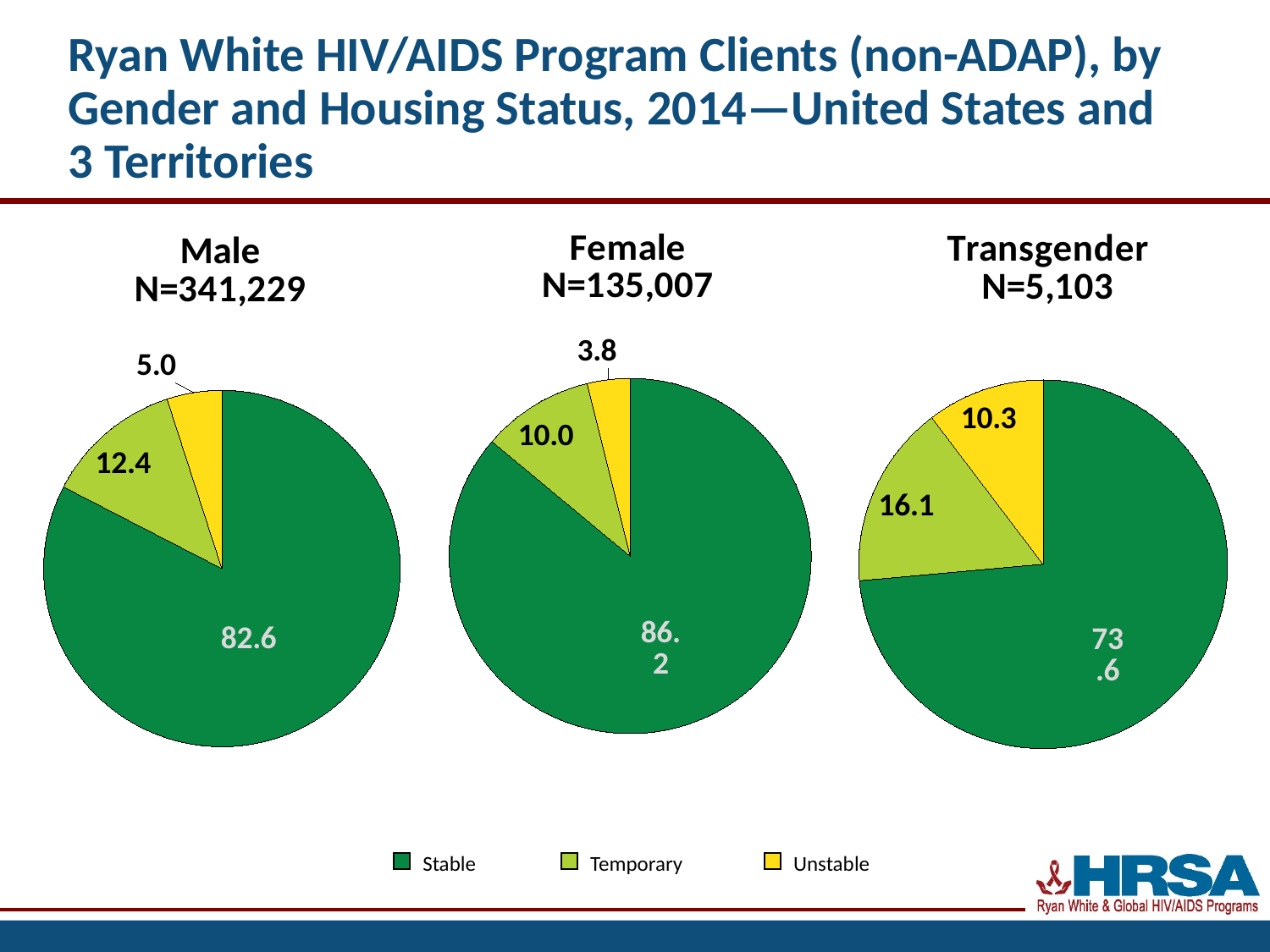
Is the Stable value larger in the Female pie chart or the Transgender pie chart? Female In the Transgender pie chart, what is the value for Unstable housing? 10.3 How many pie charts are shown on the slide? 3 What type of chart is used to show housing status for each gender? Pie chart In the Male pie chart, what percentage of clients have stable housing? 82.6 In the Transgender pie chart, what is the difference between the Temporary and Unstable values? 5.8 How many housing status categories does the legend list? 3 In the Female pie chart, what is the value for Temporary housing? 10.0 In the Male pie chart, what is the value for Unstable housing? 5.0 What is the N value shown for the Female pie chart? N=135,007 In the Female pie chart, which housing status has the smallest slice? Unstable In the Transgender pie chart, which housing status has the largest slice? Stable